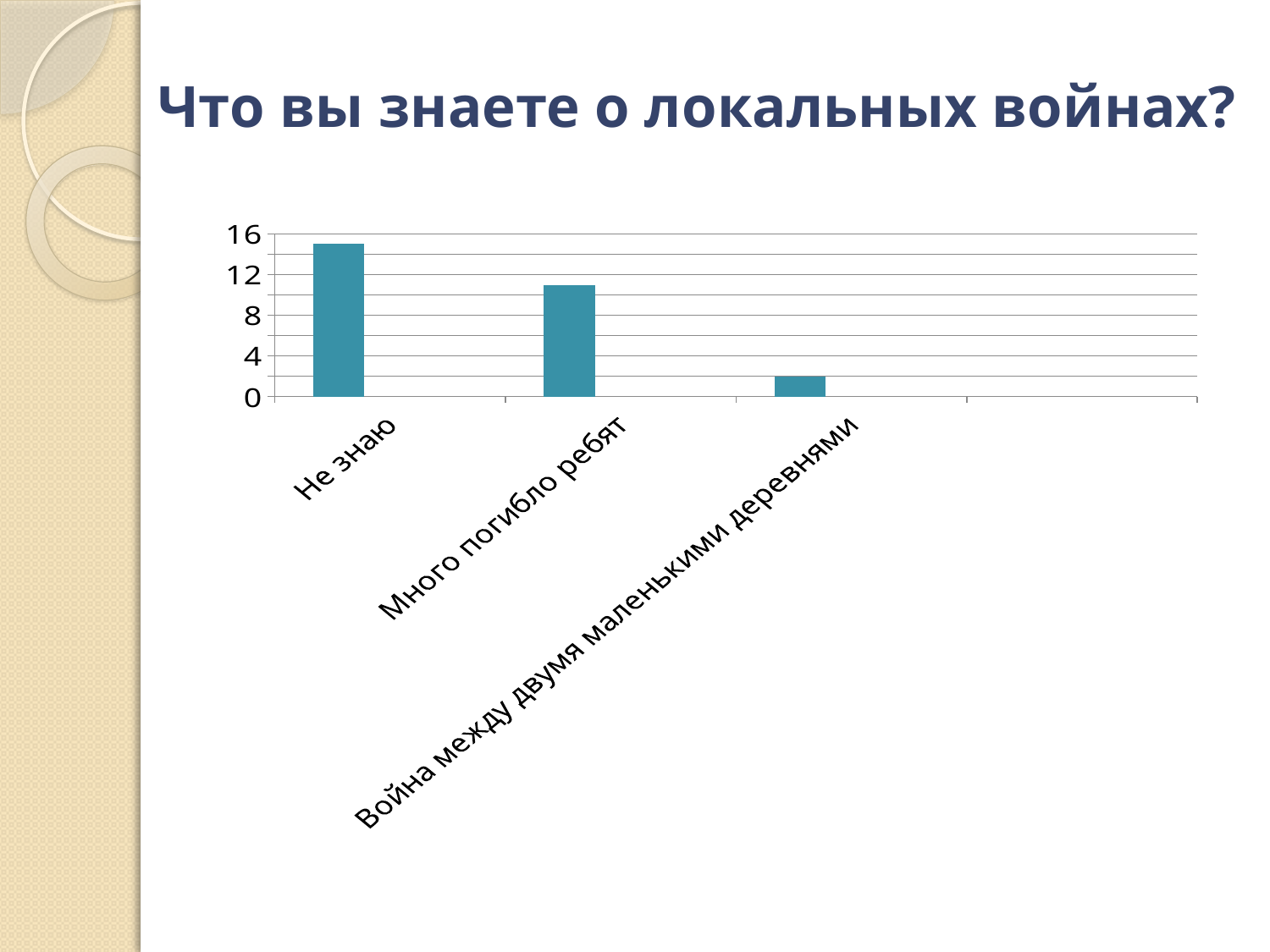
Is the value for Не знаю greater or less than 12? greater Is the value for Много погибло ребят greater or less than 12? less What is the title of the slide containing the chart? Что вы знаете о локальных войнах? Which category has the highest bar? Не знаю What kind of chart is shown on the slide? bar chart How many categories are shown on the x axis of the chart? 3 Which is larger, the value for Не знаю or the value for Много погибло ребят? Не знаю Do the bar values rise or fall from left to right along the x axis? fall Which category has the lowest bar? Война между двумя маленькими деревнями Is the value for Много погибло ребят greater or less than 8? greater What is the highest value shown on the vertical axis of the chart? 16